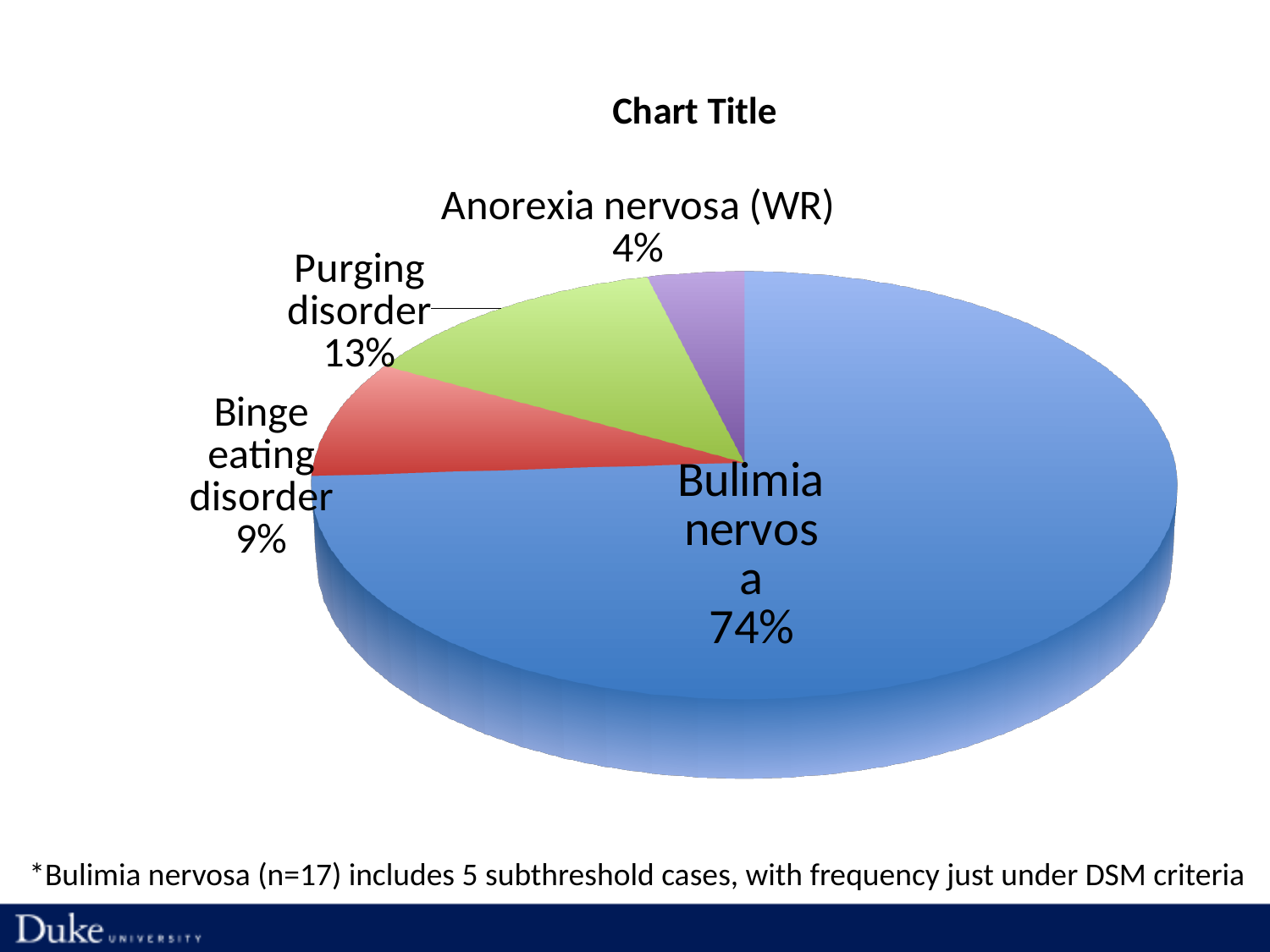
What share of the pie does Bulimia nervosa represent? 74% Which is larger, the share for Purging disorder or the share for Binge eating disorder? Purging disorder What colour is the Bulimia nervosa slice? Blue What kind of chart is shown on the slide? Pie chart What is the difference in percentage points between Purging disorder and Binge eating disorder? 4 Which category has the largest slice of the pie? Bulimia nervosa Which category has the smallest slice of the pie? Anorexia nervosa (WR) What share of the pie does Anorexia nervosa (WR) represent? 4% How many categories are shown in the pie chart? 4 What share of the pie does Purging disorder represent? 13% What is the title shown above the pie chart? Chart Title